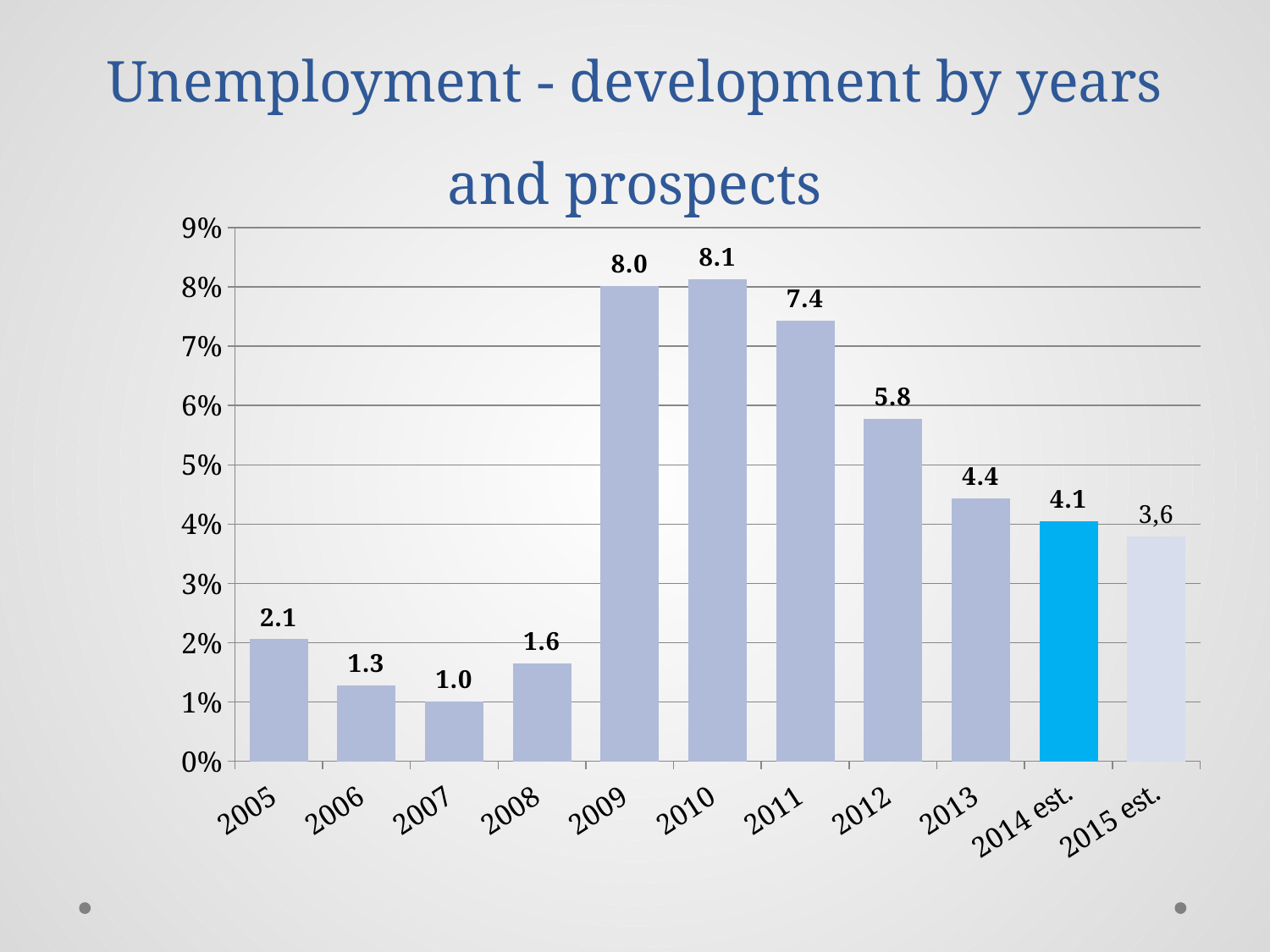
Do the values rise or fall from 2010 to 2015 est.? fall Is the value for 2013 greater or less than 5%? less What is the unemployment value shown for 2007? 1.0 What is the title of the chart on the slide? Unemployment - development by years and prospects What is the difference between the values for 2009 and 2005? 5.9 Which is larger, the value for 2011 or the value for 2012? 2011 What value is labelled for 2015 est.? 3,6 What is the unemployment value shown for 2010? 8.1 Which year has the lowest unemployment value? 2007 What kind of chart is shown on the slide? bar chart How many years (categories) are shown on the x axis? 11 Which year has the highest unemployment value? 2010